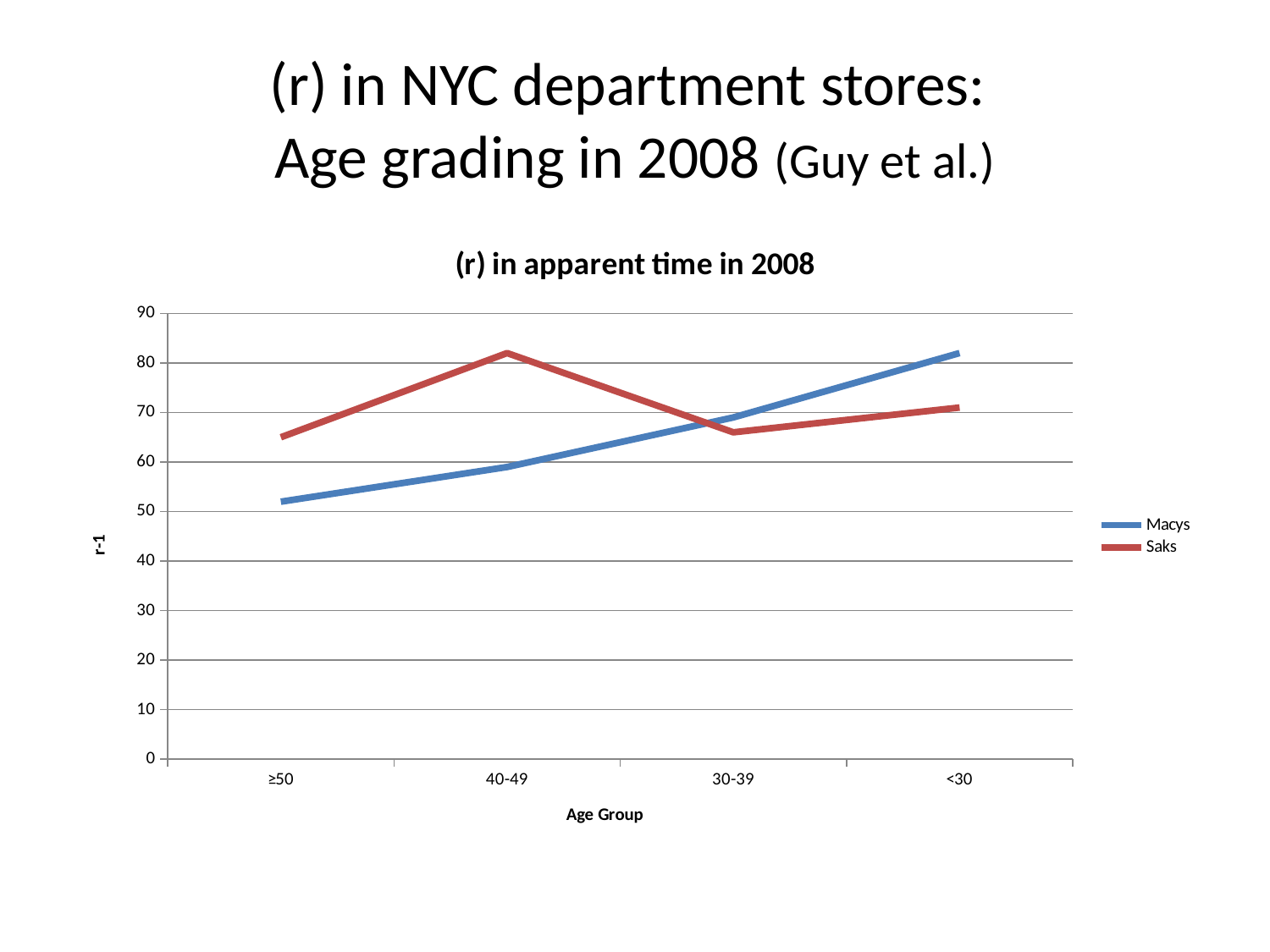
Does the Macys line rise or fall from the ≥50 group to the <30 group? rise Which age group has the highest value for Saks? 40-49 What kind of chart is shown on the slide? line chart In the 40-49 age group, which series has the larger value, Macys or Saks? Saks How many series does the legend list? 2 What is the label of the x axis? Age Group Is the value for Macys in the <30 age group greater or less than 80? greater What is the title of the chart? (r) in apparent time in 2008 How many age groups are plotted along the x axis? 4 Is the value for Macys in the ≥50 age group greater or less than 60? less Which age group has the lowest value for Macys? ≥50 Is the value for Saks in the 40-49 age group greater or less than 80? greater